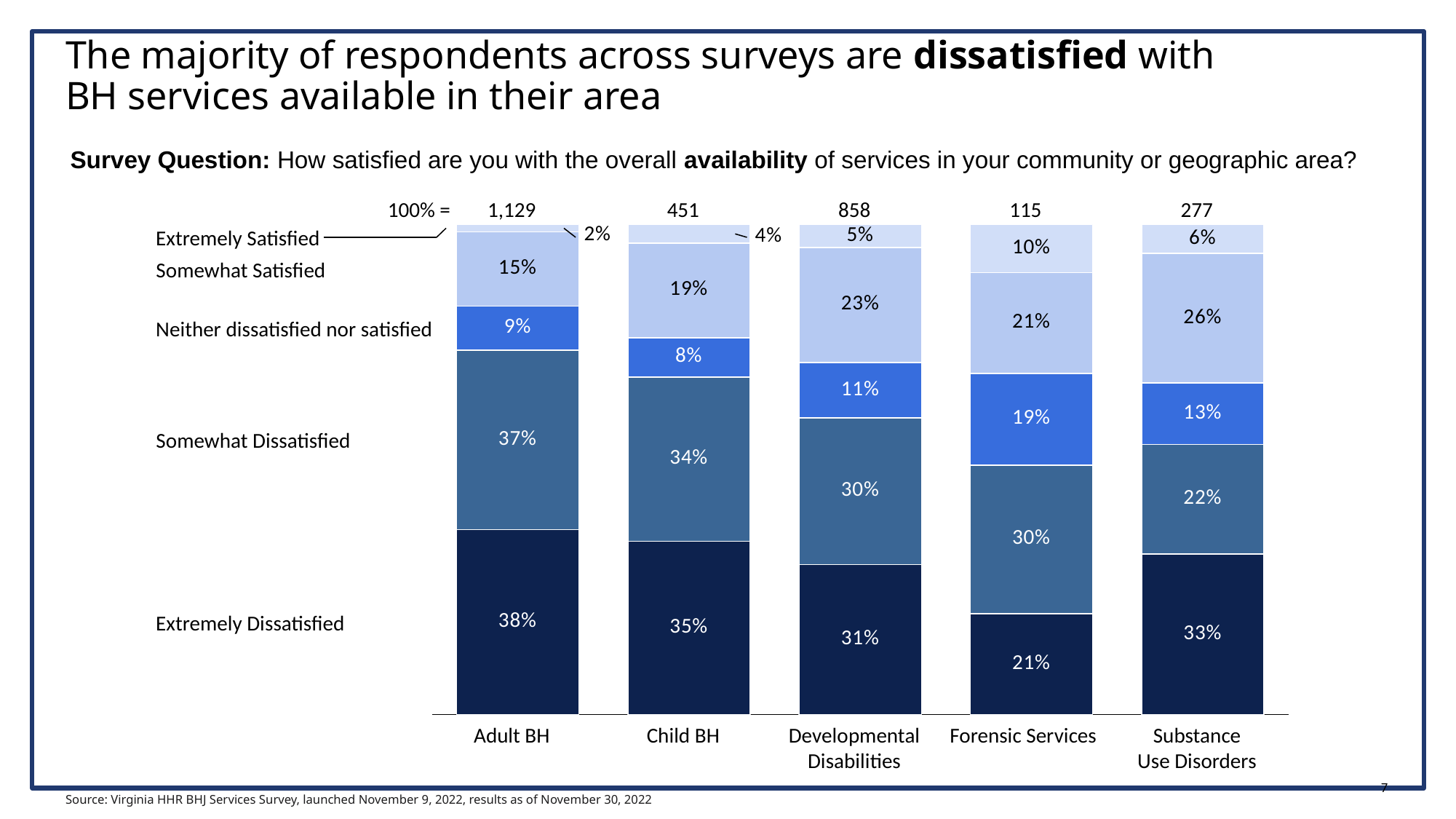
What is the difference between the Somewhat Dissatisfied share for Adult BH and for Substance Use Disorders? 15 percentage points What kind of chart is shown on the slide? Stacked bar chart How many surveys (bars) are shown in the chart? 5 Which survey has the highest share of Extremely Dissatisfied respondents? Adult BH How many satisfaction categories are stacked in each bar? 5 Which is larger: the Neither dissatisfied nor satisfied share for Forensic Services or for Child BH? Forensic Services Which survey has the lowest share of Extremely Satisfied respondents? Adult BH What percentage of Adult BH respondents are Extremely Dissatisfied? 38% What percentage of Substance Use Disorders respondents are Somewhat Satisfied? 26% What percentage of Forensic Services respondents are Extremely Satisfied? 10% What is the number of respondents (100% =) for the Developmental Disabilities survey? 858 What is the combined share of Somewhat Dissatisfied and Extremely Dissatisfied respondents for Child BH? 69%